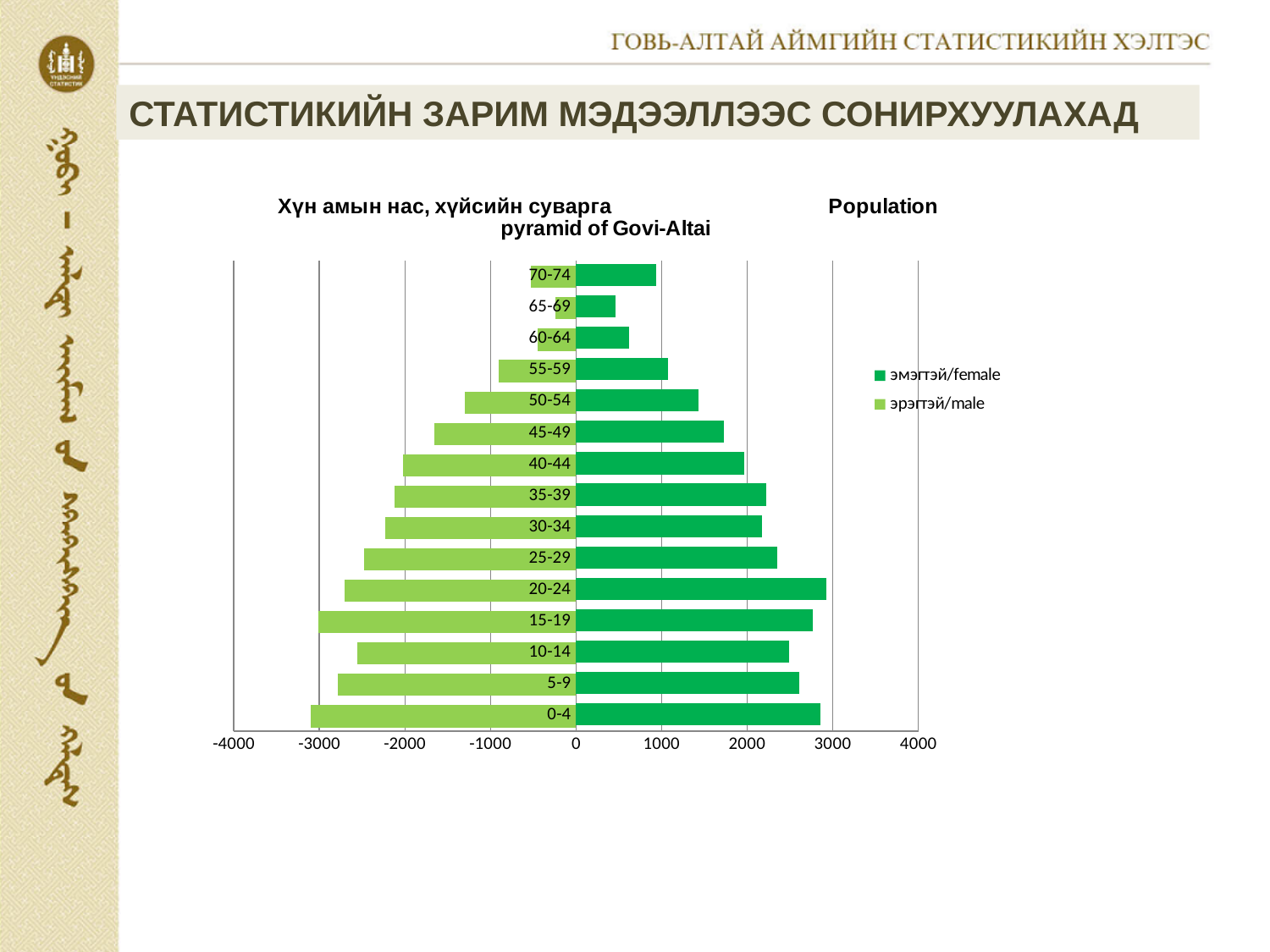
Is the female value for the 45-49 age group greater or less than 1500? greater Which age group has the shortest female (эмэгтэй/female) bar? 65-69 How many series does the legend list? 2 What kind of chart is shown on the slide? bar chart Is the female value for the 20-24 age group greater or less than 2500? greater Do the female bars generally get shorter as the age group increases from 0-4 to 70-74? yes Which age group has the shortest male (эрэгтэй/male) bar? 65-69 Which is larger, the female value for 35-39 or the female value for 60-64? 35-39 Is the female value for the 70-74 age group greater or less than 1000? less Which is larger, the female value for 0-4 or the female value for 10-14? 0-4 What are the two legend entries on the chart? эмэгтэй/female and эрэгтэй/male How many age groups are shown on the chart? 15